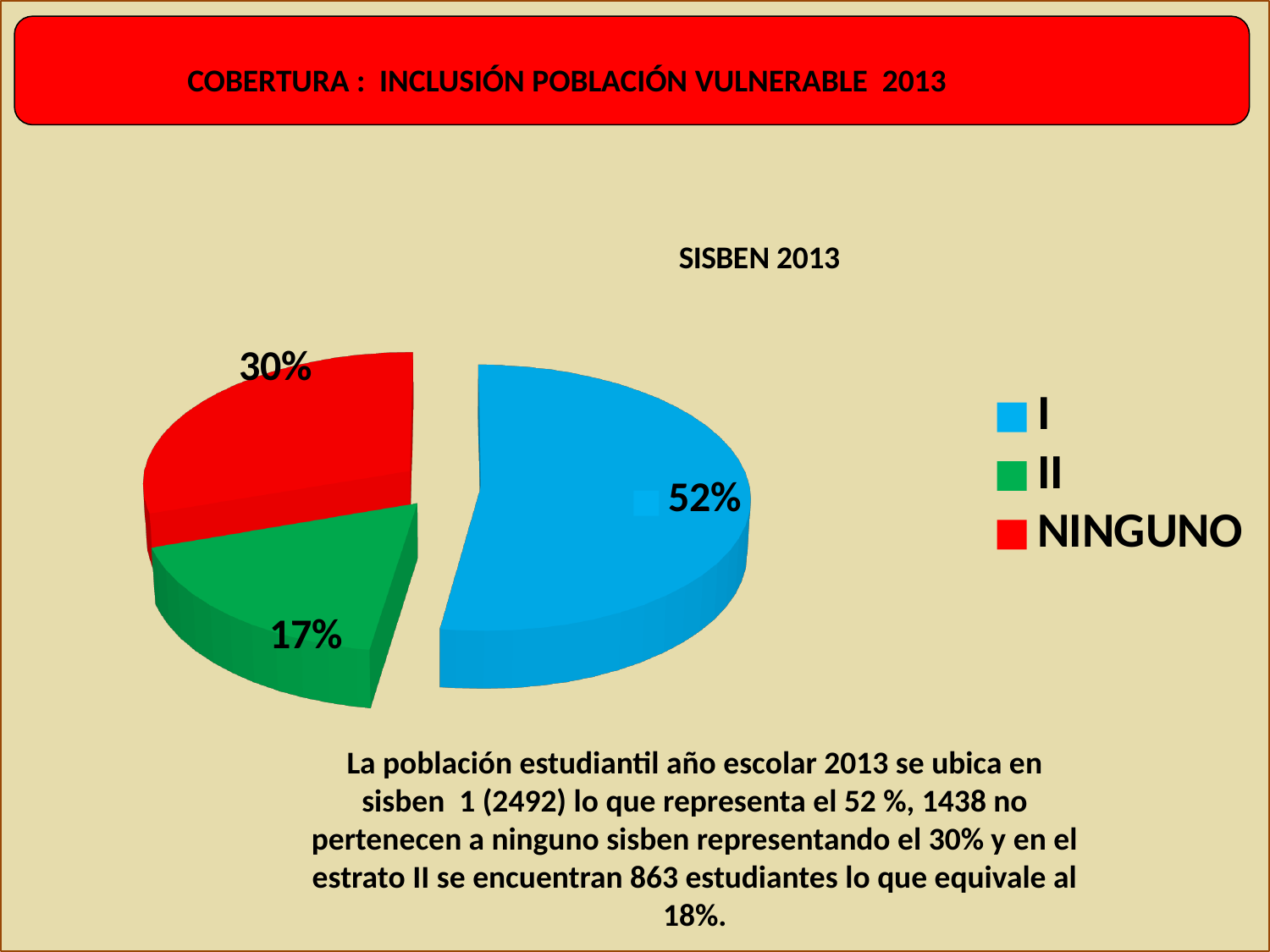
Which slice is larger, NINGUNO or II? NINGUNO What colour is the slice for NINGUNO? red How many slices does the pie chart have? 3 What percentage does the slice for NINGUNO represent? 30% How many entries does the legend list? 3 What kind of chart is shown on the slide? pie chart What percentage does the slice for II represent? 17% What is the title of the chart? SISBEN 2013 What percentage does the slice for I represent? 52% Which category has the largest slice of the pie? I Which category has the smallest slice of the pie? II What is the difference in percentage points between the I slice and the NINGUNO slice? 22